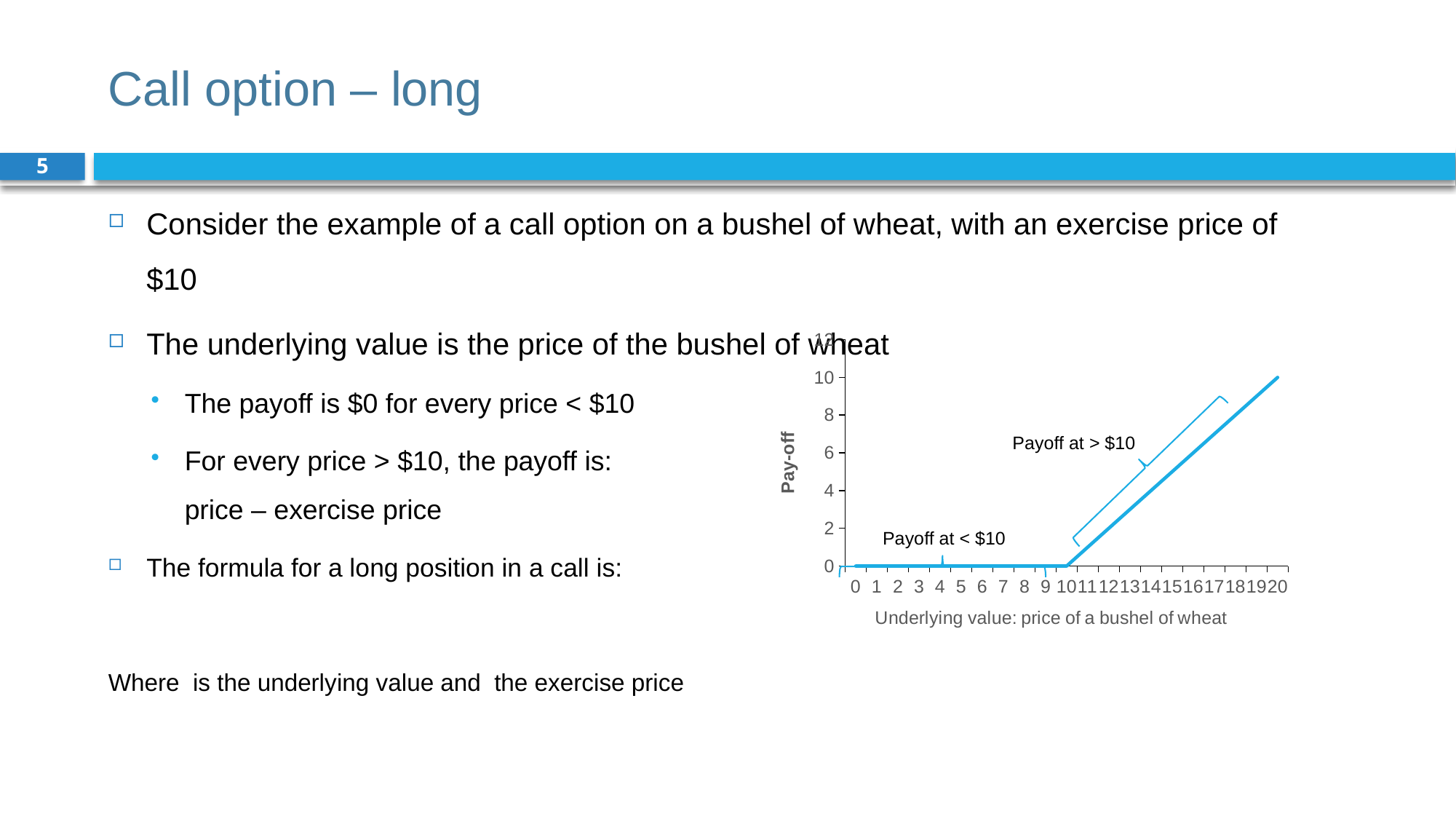
At what underlying value does the pay-off line start to rise above 0? 10 Which has the larger pay-off: an underlying value of 12 or an underlying value of 18? 18 Is the pay-off at an underlying value of 15 greater or less than 4? greater Is the pay-off at an underlying value of 12 greater or less than 4? less What is the title of the y axis of the chart? Pay-off At which underlying value on the x axis is the pay-off highest? 20 What is the pay-off when the price of a bushel of wheat is 5? 0 Is the pay-off at an underlying value of 18 greater or less than 6? greater What is the title of the x axis of the chart? Underlying value: price of a bushel of wheat What kind of chart is shown on the slide? line chart Does the pay-off rise or fall as the underlying value increases from 10 to 20? rises What is the pay-off when the price of a bushel of wheat is 20? 10